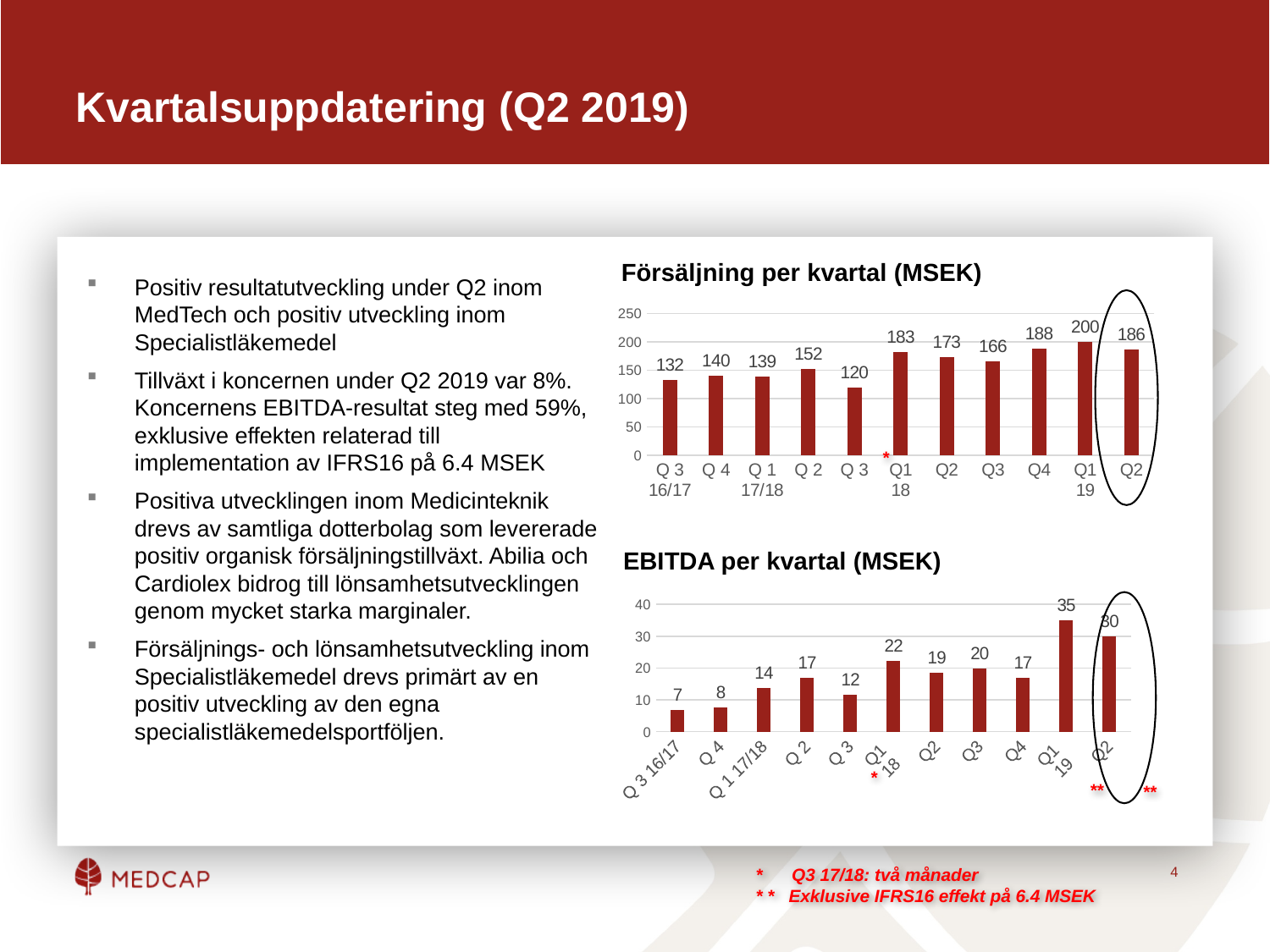
In the 'EBITDA per kvartal (MSEK)' chart, what is the value for Q1 19? 35 In the 'Försäljning per kvartal (MSEK)' chart, which quarter has the highest value? Q1 19 In the 'Försäljning per kvartal (MSEK)' chart, is the value for Q4 18 greater or less than 150? greater In the 'Försäljning per kvartal (MSEK)' chart, which quarter has the lowest value? Q3 17/18 In the 'EBITDA per kvartal (MSEK)' chart, what is the difference between Q1 19 and Q4 18? 18 In the 'Försäljning per kvartal (MSEK)' chart, what is the difference between Q1 19 and Q2 19? 14 In the 'EBITDA per kvartal (MSEK)' chart, which quarter has the lowest value? Q3 16/17 What type of chart is the 'EBITDA per kvartal (MSEK)' chart? Bar chart In the 'Försäljning per kvartal (MSEK)' chart, how many bars are plotted? 11 In the 'Försäljning per kvartal (MSEK)' chart, what is the value for Q2 19? 186 In the 'EBITDA per kvartal (MSEK)' chart, which is larger, Q1 18 or Q2 18? Q1 18 In the 'Försäljning per kvartal (MSEK)' chart, what is the value for Q3 17/18? 120